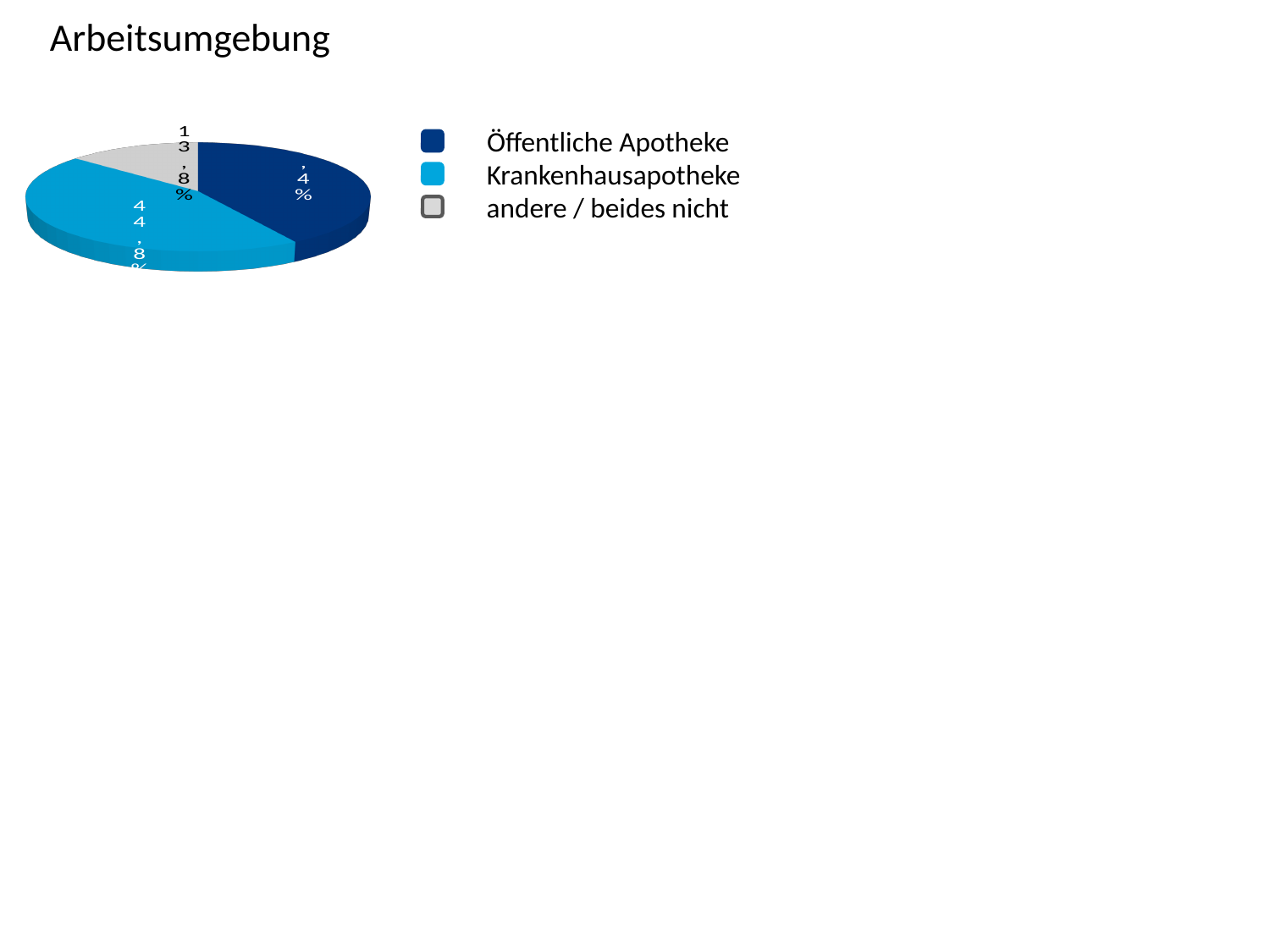
What kind of chart is shown on the slide? pie chart How many slices does the pie chart have? 3 What share of the pie does 'andere / beides nicht' represent? 13,8% What percentage is shown for the 'Krankenhausapotheke' slice? 44,8% What percentage is shown for the 'andere / beides nicht' slice? 13,8% Which slice is larger: 'Krankenhausapotheke' or 'andere / beides nicht'? Krankenhausapotheke How many entries does the legend list? 3 Which slice is larger: 'Öffentliche Apotheke' or 'andere / beides nicht'? Öffentliche Apotheke Which category has the smallest slice of the pie? andere / beides nicht What colour represents 'Krankenhausapotheke' in the pie chart? light blue What is the title of the slide above the pie chart? Arbeitsumgebung